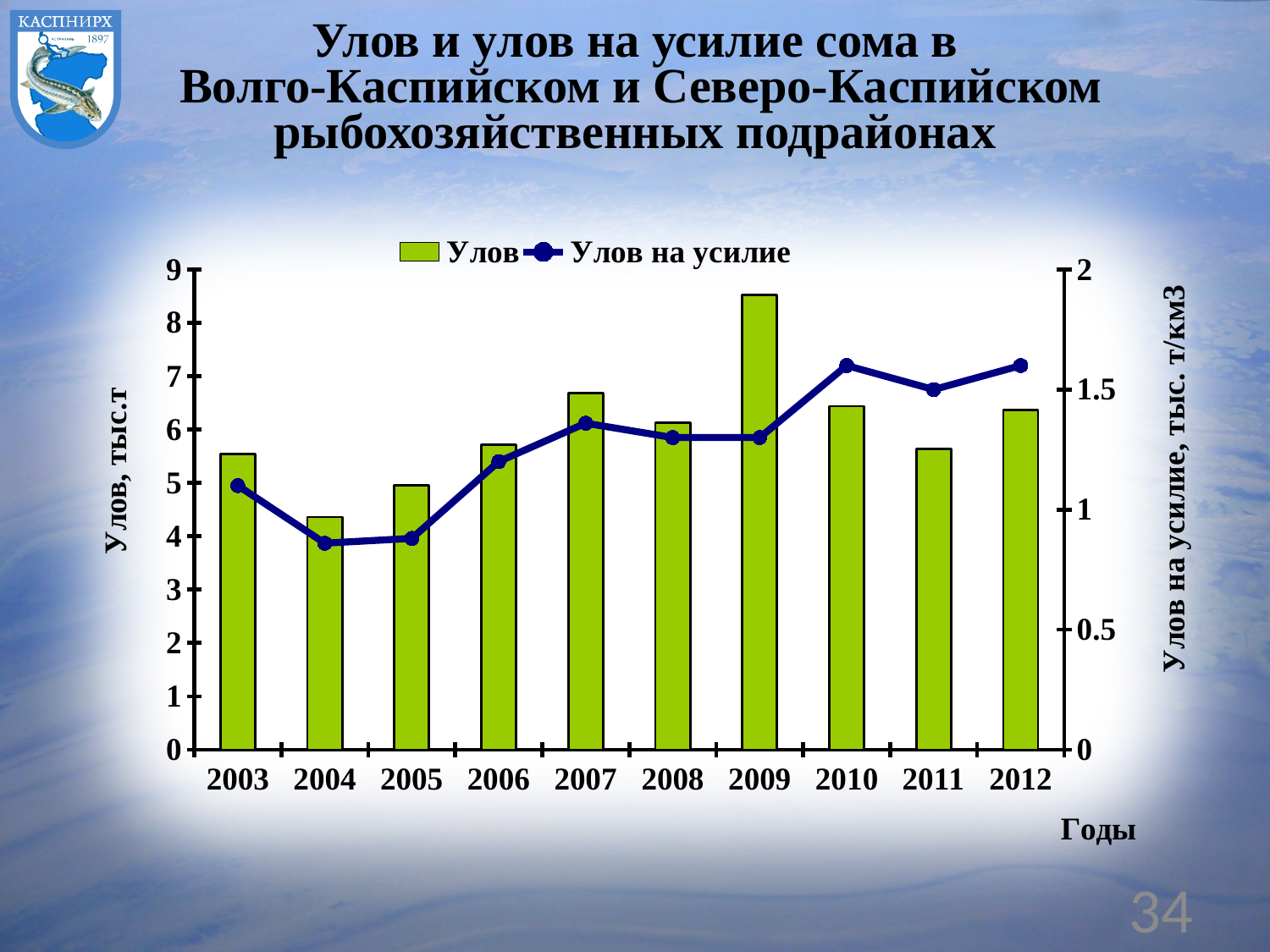
Is the value for Улов на усилие in 2004 greater or less than 1? less Which is larger, the Улов на усилие value for 2003 or for 2010? 2010 Is the value for Улов in 2004 greater or less than 5? less Which is larger, the Улов value for 2007 or for 2011? 2007 Is the value for Улов на усилие in 2010 greater or less than 1.5? greater Does the Улов на усилие line rise or fall from 2003 to 2004? fall How many series does the legend list? 2 Which year has the highest value for Улов? 2009 What kind of chart is shown on the slide? Combined bar and line chart Which year has the lowest value for Улов? 2004 How many years are shown on the x axis? 10